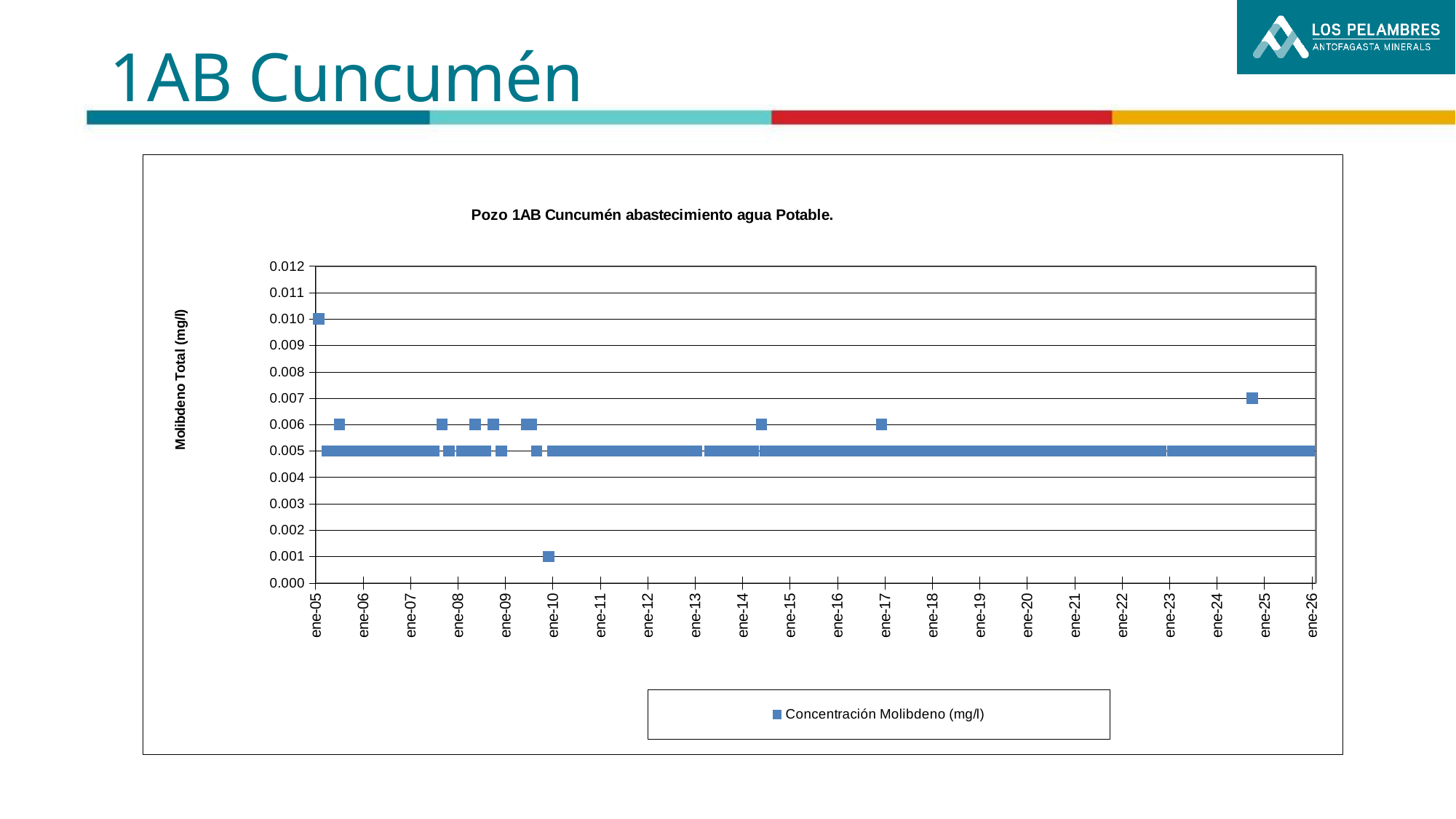
At which value do most of the plotted points lie? 0.005 How many series does the legend list? 1 What kind of chart is shown on the slide? scatter chart What is the value of the point plotted just before ene-25? 0.007 How many year labels are shown on the horizontal axis? 22 What is the label of the vertical axis? Molibdeno Total (mg/l) What is the maximum value shown on the vertical axis? 0.012 What is the lowest molybdenum concentration value plotted on the chart? 0.001 Is the value of the point plotted just before ene-25 greater or less than 0.006? greater Is the value of the point plotted near ene-10 greater or less than 0.002? less What is the title of the chart? Pozo 1AB Cuncumén abastecimiento agua Potable. What is the highest molybdenum concentration value plotted on the chart? 0.010